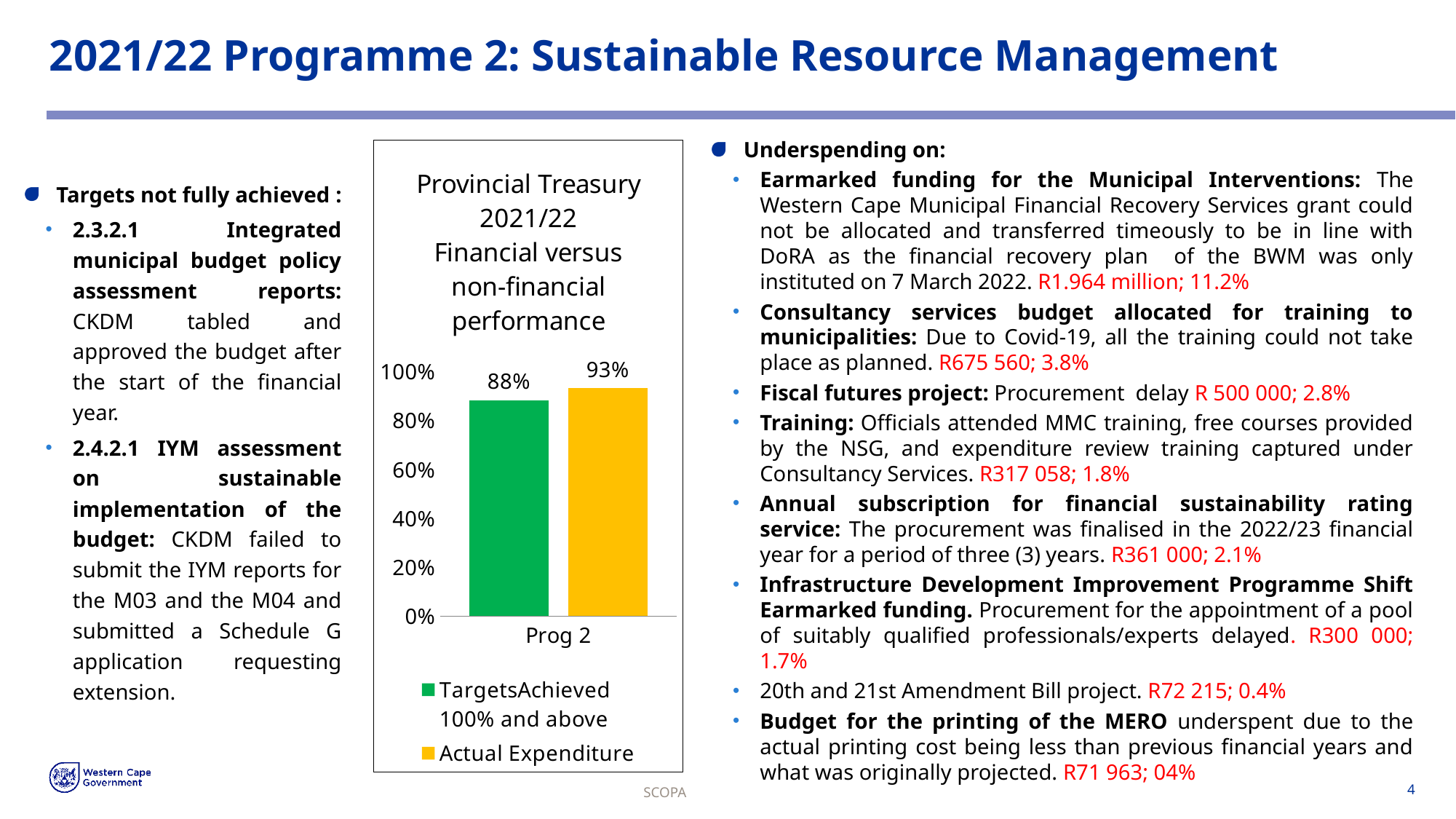
What is the value of Targets Achieved 100% and above for Prog 2? 88% What kind of chart is shown on the slide? Bar chart Is the value for Targets Achieved 100% and above greater or less than 80%? greater What colour is the Actual Expenditure bar in the chart? Yellow How many categories are shown on the x axis of the chart? 1 What is the value of Actual Expenditure for Prog 2? 93% What is the title of the chart? Provincial Treasury 2021/22 Financial versus non-financial performance What is the difference between Actual Expenditure and Targets Achieved 100% and above for Prog 2? 5% Which series has the higher value for Prog 2, Targets Achieved 100% and above or Actual Expenditure? Actual Expenditure Is the value for Actual Expenditure greater or less than 100%? less How many series does the chart legend list? 2 What is the category label on the x axis of the chart? Prog 2